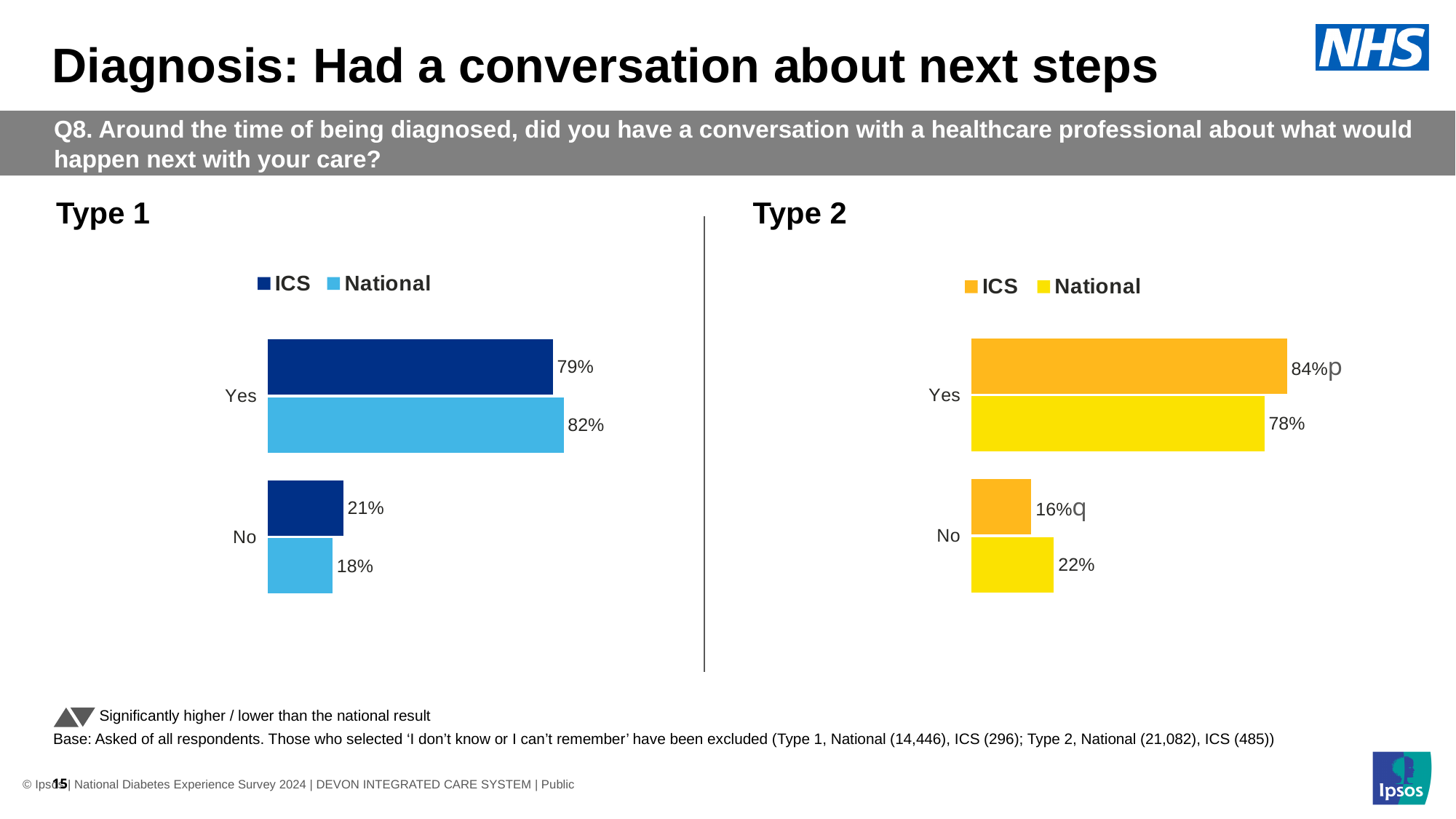
How many series does the legend of the Type 2 chart list? 2 In the Type 1 chart, which is larger for Yes: ICS or National? National In the Type 2 chart, what is the difference between the ICS and National values for Yes? 6 percentage points In the Type 2 chart, what colour represents the National series? Yellow In the Type 1 chart, what is the difference between the National and ICS values for Yes? 3 percentage points In the Type 1 chart, what is the ICS value for Yes? 79% In the Type 2 chart, what is the National value for No? 22% What kind of chart is the Type 1 chart? Bar chart In the Type 1 chart, what is the National value for No? 18% In the Type 2 chart, what is the ICS value for Yes? 84% In the Type 2 chart, which is larger for No: ICS or National? National How many categories are shown in the Type 1 chart? 2